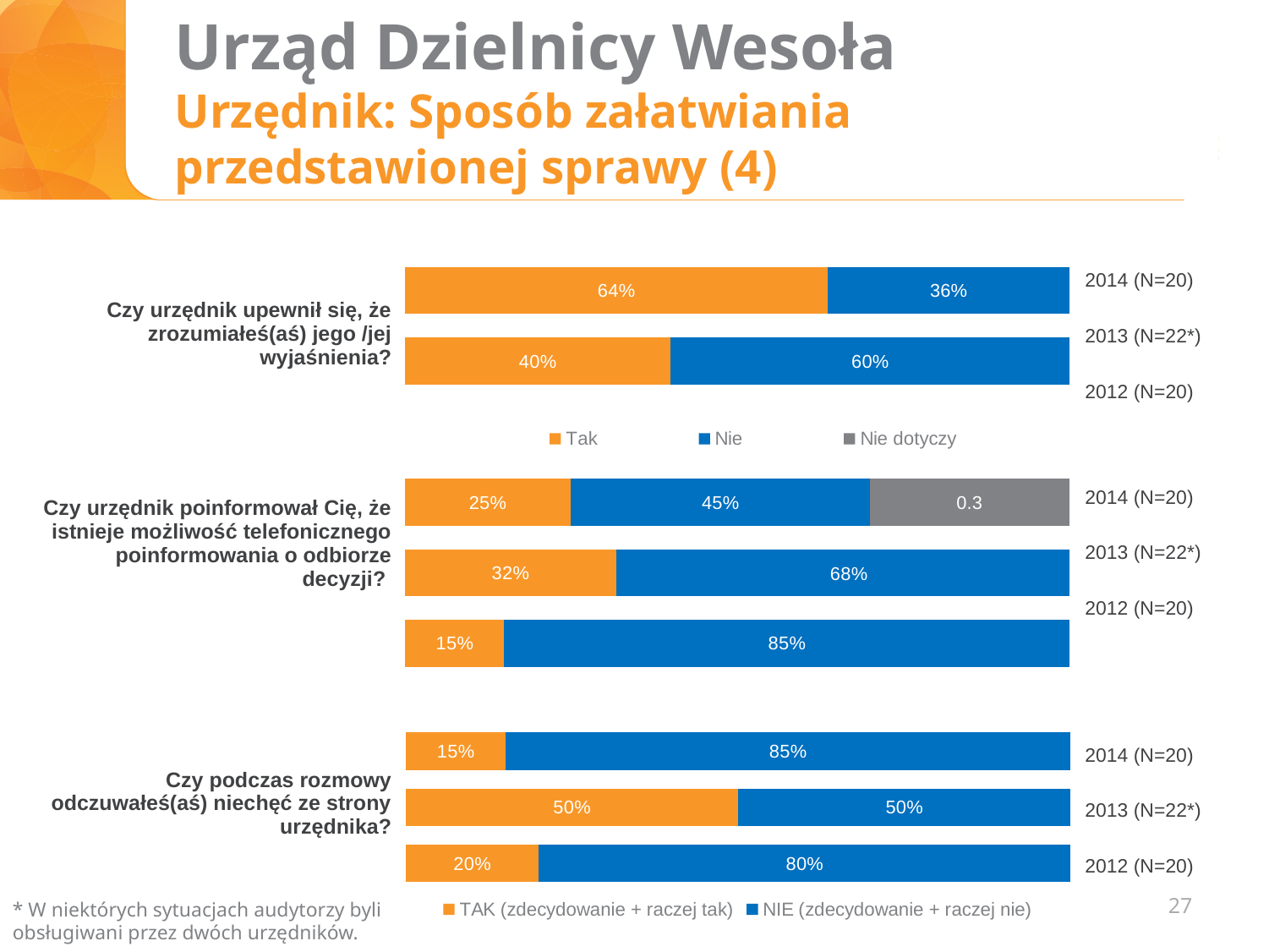
In the middle chart ("Czy urzędnik poinformował Cię, że istnieje możliwość telefonicznego poinformowania o odbiorze decyzji?"), what is the value for Nie in 2014 (N=20)? 45% In the top chart, what is the difference between the Tak values for 2014 and 2013? 24 percentage points In the middle chart, what label is shown on the Nie dotyczy segment for 2014? 0.3 In the top chart, what is the value for Nie in 2013 (N=22*)? 60% In the top chart ("Czy urzędnik upewnił się, że zrozumiałeś(aś) jego /jej wyjaśnienia?"), what is the value for Tak in 2014 (N=20)? 64% How many series does the legend of the middle chart list? 3 What type of chart is used on this slide? Stacked bar chart In the bottom chart, what is the total of the stacked bar for 2013 (N=22*)? 100% In the bottom chart, which is larger: the TAK value for 2013 or the TAK value for 2014? 2013 In the middle chart, which year has the highest Nie value? 2012 (N=20) In the middle chart, which year has the lowest Tak value? 2012 (N=20) In the bottom chart ("Czy podczas rozmowy odczuwałeś(aś) niechęć ze strony urzędnika?"), what is the value for NIE in 2012 (N=20)? 80%